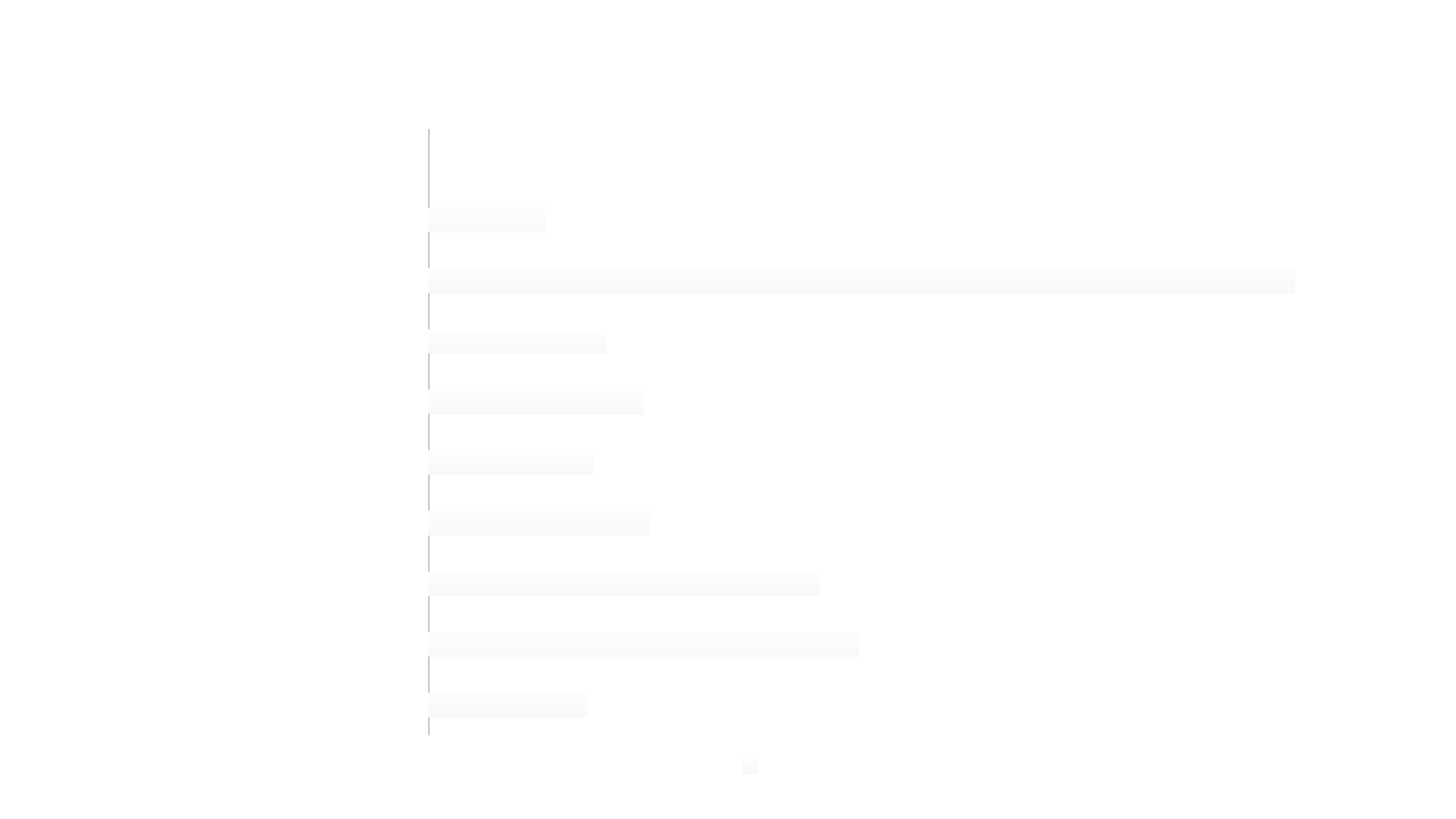
Are the bars in the chart drawn horizontally or vertically? horizontally How many bars does the chart show? 9 Counting from the top, which bar is the shortest? the first bar What kind of chart is shown on the slide? bar chart Counting from the top, which bar is the longest? the second bar